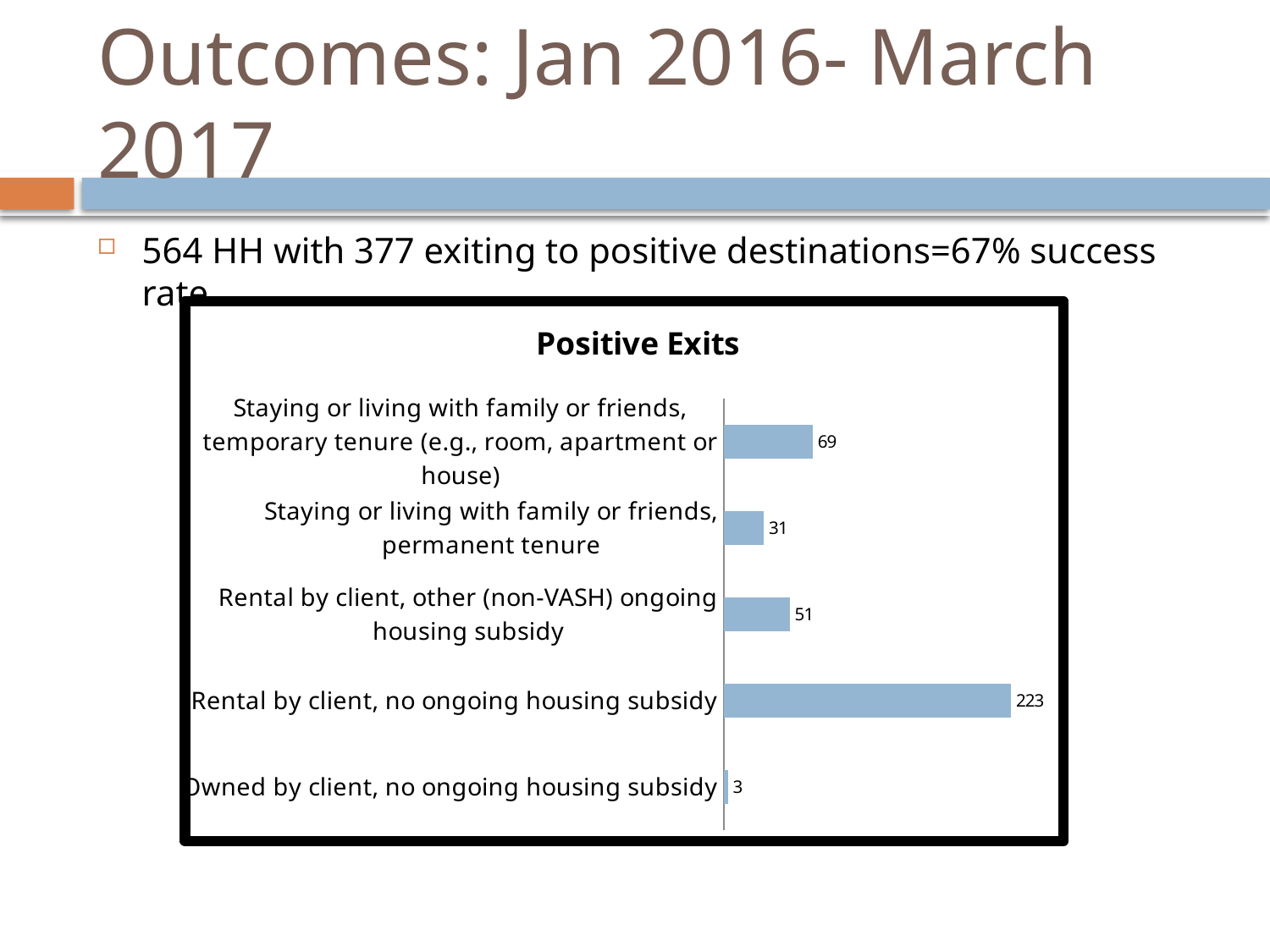
What is the value for 'Rental by client, other (non-VASH) ongoing housing subsidy' in the Positive Exits chart? 51 What is the value for 'Rental by client, no ongoing housing subsidy' in the Positive Exits chart? 223 Which category has the lowest value in the Positive Exits chart? Owned by client, no ongoing housing subsidy How many categories are shown in the Positive Exits chart? 5 What is the value for 'Owned by client, no ongoing housing subsidy' in the Positive Exits chart? 3 Which is larger in the Positive Exits chart: 'Rental by client, other (non-VASH) ongoing housing subsidy' or 'Staying or living with family or friends, permanent tenure'? Rental by client, other (non-VASH) ongoing housing subsidy Which category has the highest value in the Positive Exits chart? Rental by client, no ongoing housing subsidy What kind of chart is the Positive Exits chart? Bar chart What is the difference between the values for 'Rental by client, no ongoing housing subsidy' and 'Staying or living with family or friends, temporary tenure' in the Positive Exits chart? 154 What is the title of the chart on the slide? Positive Exits What is the value for 'Staying or living with family or friends, permanent tenure' in the Positive Exits chart? 31 What is the value for 'Staying or living with family or friends, temporary tenure (e.g., room, apartment or house)' in the Positive Exits chart? 69